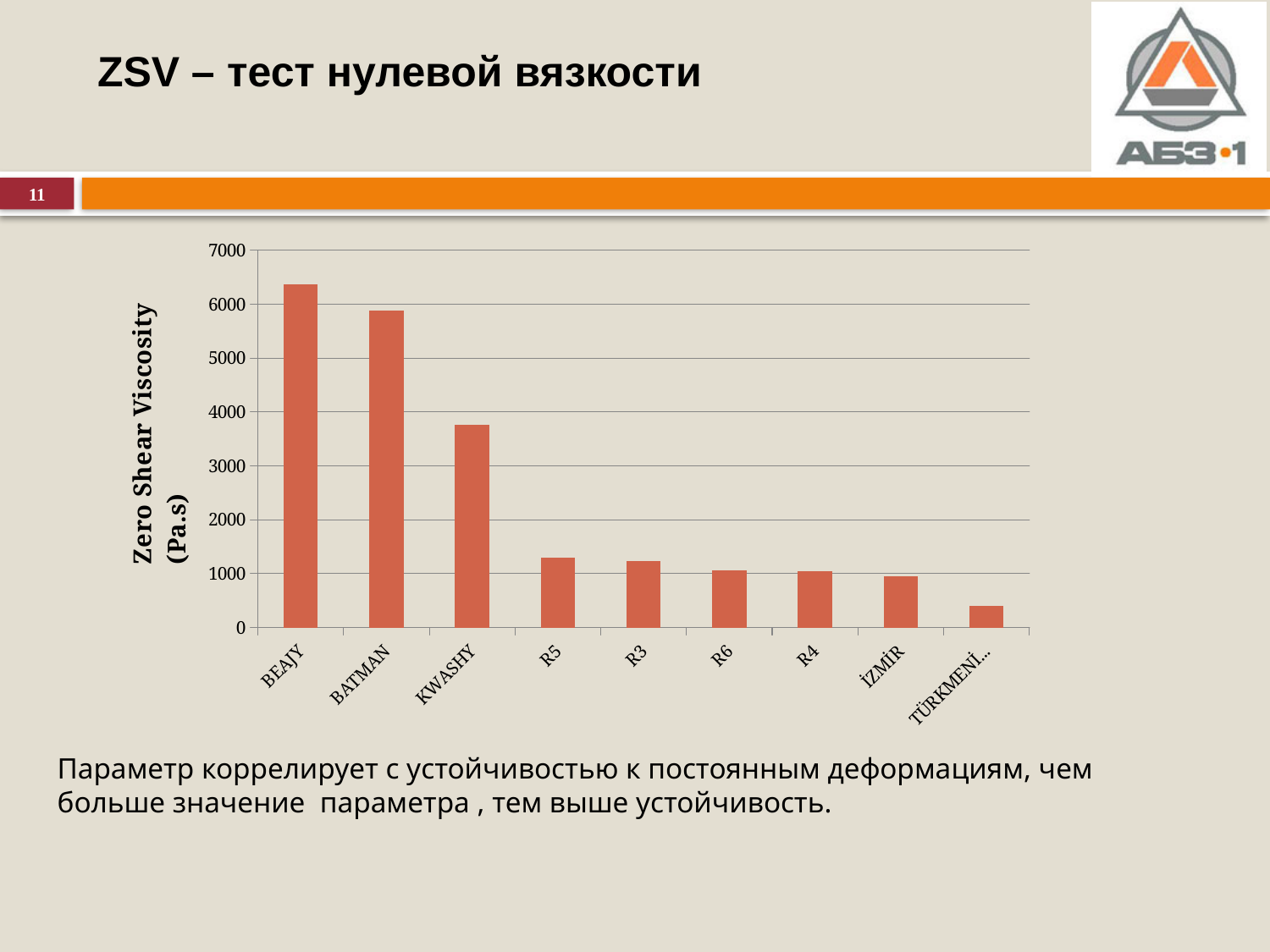
Is the value for R5 greater or less than 1000? greater Is the value for BATMAN greater or less than 6000? less What kind of chart is shown on the slide? bar chart Is the value for KWASHY greater or less than 4000? less What is the title of the vertical axis of the chart? Zero Shear Viscosity (Pa.s) Which category has the highest Zero Shear Viscosity value? BEAJY Do the bar values rise or fall from left to right along the x axis? fall How many categories are plotted on the x axis of the chart? 9 Which has a larger value, KWASHY or R5? KWASHY Which has a larger value, BATMAN or KWASHY? BATMAN